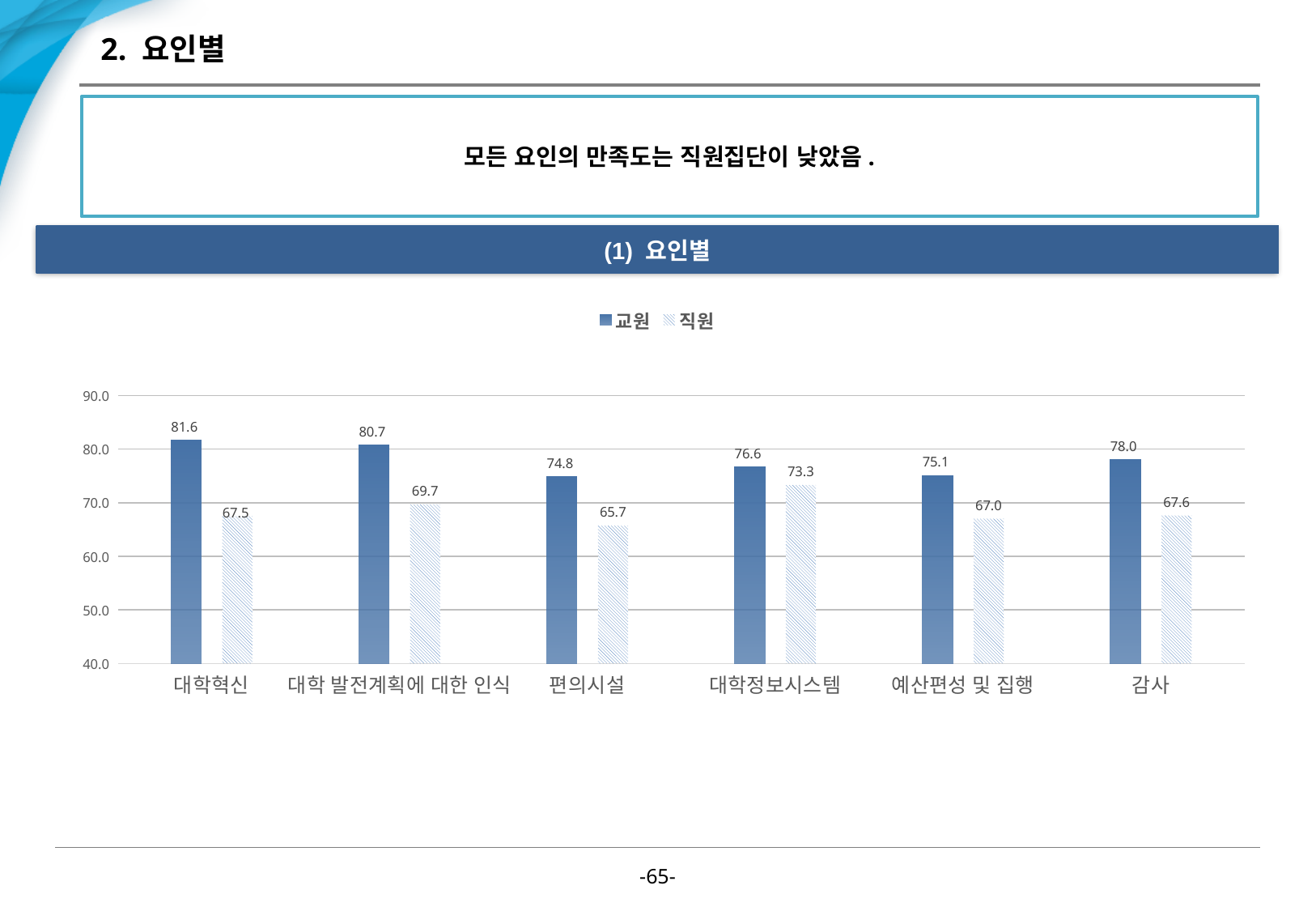
What is the difference between the 교원 and 직원 values in the 대학혁신 category? 14.1 What is the value for 교원 in the 대학혁신 category? 81.6 Which category has the highest 교원 value? 대학혁신 Is the 교원 value for 예산편성 및 집행 greater or less than 70.0? greater What is the value for 직원 in the 대학정보시스템 category? 73.3 What are the two series names listed in the legend? 교원, 직원 Which category has the lowest 직원 value? 편의시설 How many series does the legend list? 2 Which is larger: the 직원 value for 대학 발전계획에 대한 인식 or the 직원 value for 감사? 대학 발전계획에 대한 인식 What kind of chart is shown on the slide? bar chart What is the value for 직원 in the 편의시설 category? 65.7 How many categories are shown on the x axis? 6